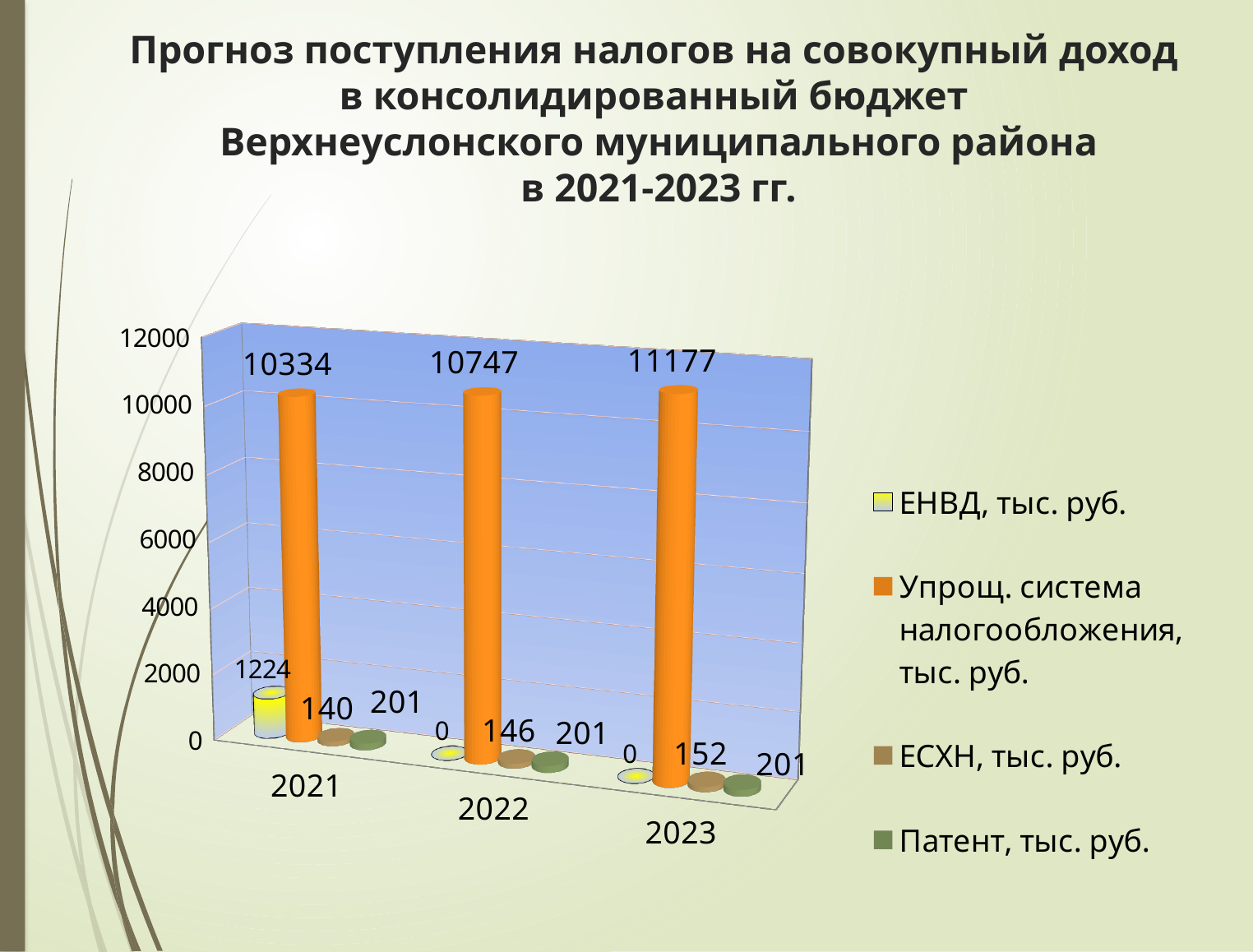
What is the value for Упрощ. система налогообложения in 2021? 10334 What is the value for ЕСХН in 2023? 152 In which year is the value for Упрощ. система налогообложения the highest? 2023 Which is larger in 2022: the value for ЕСХН or the value for Патент? Патент What is the value for ЕНВД in 2023? 0 How many series does the legend list? 4 What is the value for ЕНВД in 2021? 1224 What is the difference between the Упрощ. система налогообложения values for 2023 and 2021? 843 What is the value for Патент in 2022? 201 In which year is the value for ЕСХН the lowest? 2021 What kind of chart is shown on the slide? Bar chart Do the values for Упрощ. система налогообложения rise or fall from 2021 to 2023? Rise